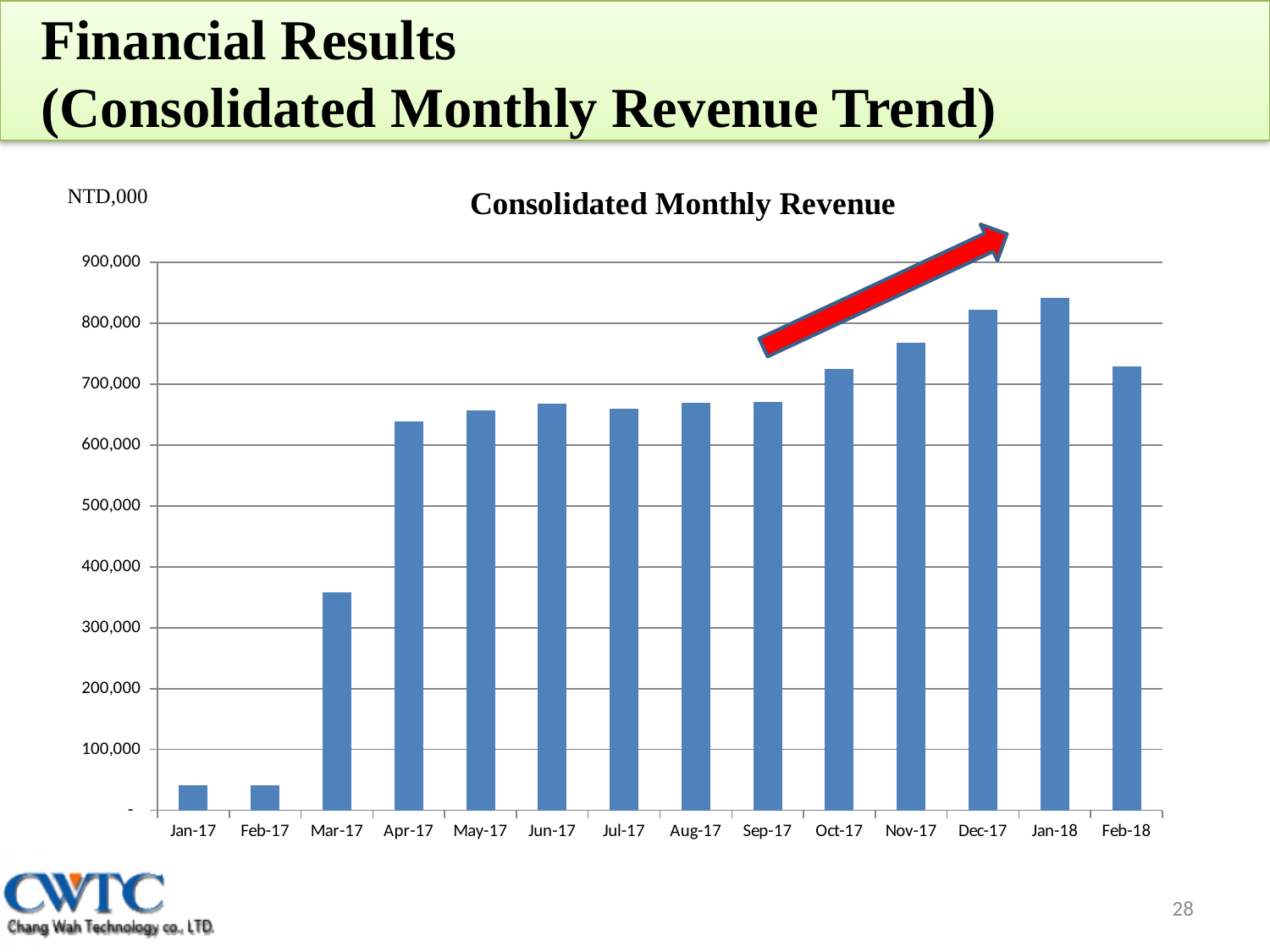
Is the value for Dec-17 greater or less than 800,000? greater Is the value for Nov-17 greater or less than 800,000? less What kind of chart is shown on the slide? bar chart Is the value for Oct-17 greater or less than 700,000? greater Do the values generally rise or fall from Apr-17 to Jan-18? rise What unit is indicated at the top left of the chart? NTD,000 Which is larger, the value for Nov-17 or the value for Oct-17? Nov-17 Which is larger, the value for Mar-17 or the value for Apr-17? Apr-17 How many months are plotted on the x axis of the chart? 14 Which month has the highest consolidated monthly revenue? Jan-18